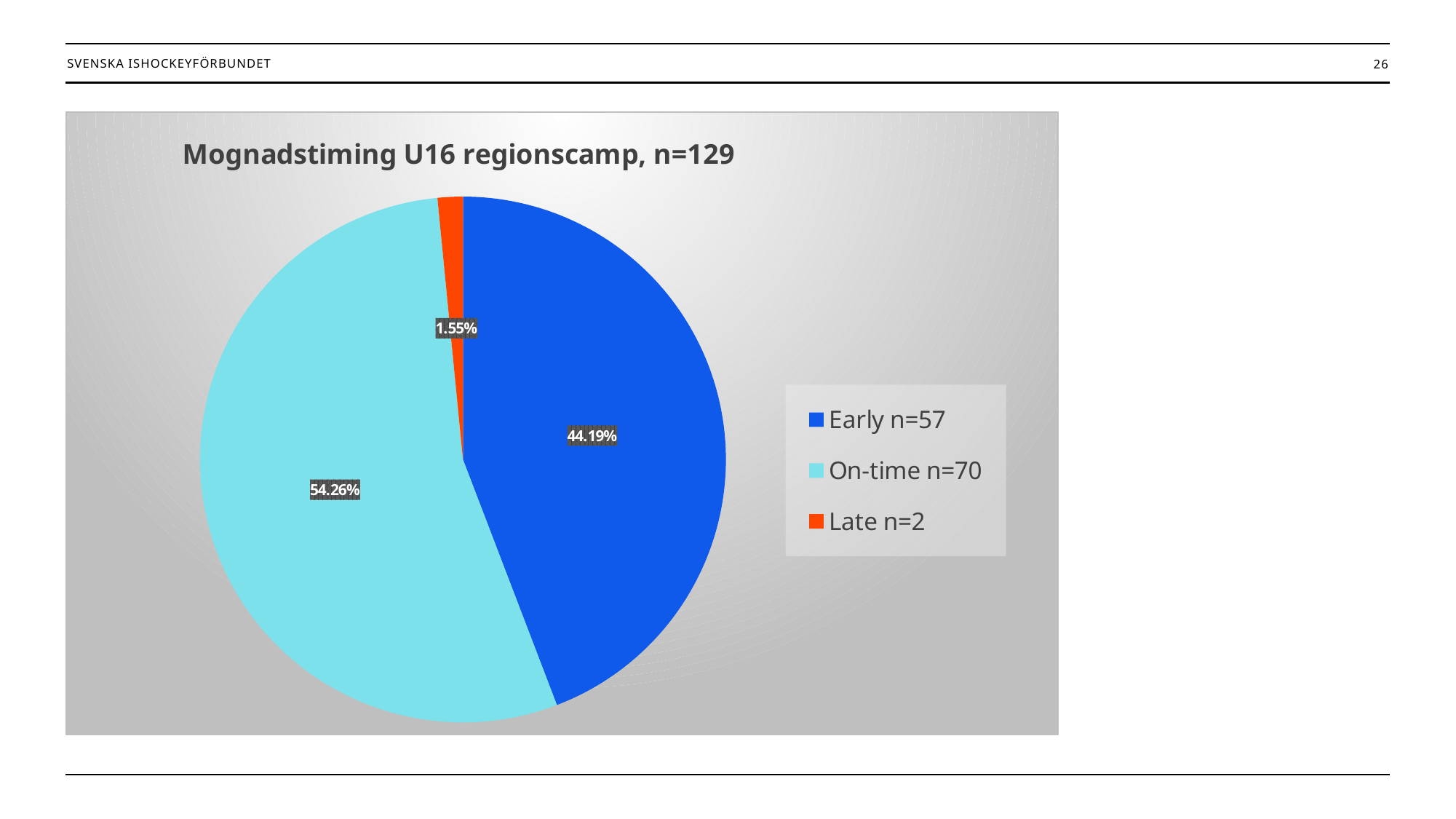
According to the legend, how many players are in the On-time group? 70 Which category has the largest slice of the pie? On-time What is the difference in percentage points between the On-time and Early slices? 10.07 What is the title of the chart? Mognadstiming U16 regionscamp, n=129 Which slice is larger, Early or On-time? On-time What percentage share does the On-time slice have? 54.26% What percentage share does the Late slice have? 1.55% What colour is the Late slice? orange-red How many categories does the pie chart show? 3 Which category has the smallest slice of the pie? Late What kind of chart is shown on the slide? pie chart What percentage share does the Early slice have? 44.19%